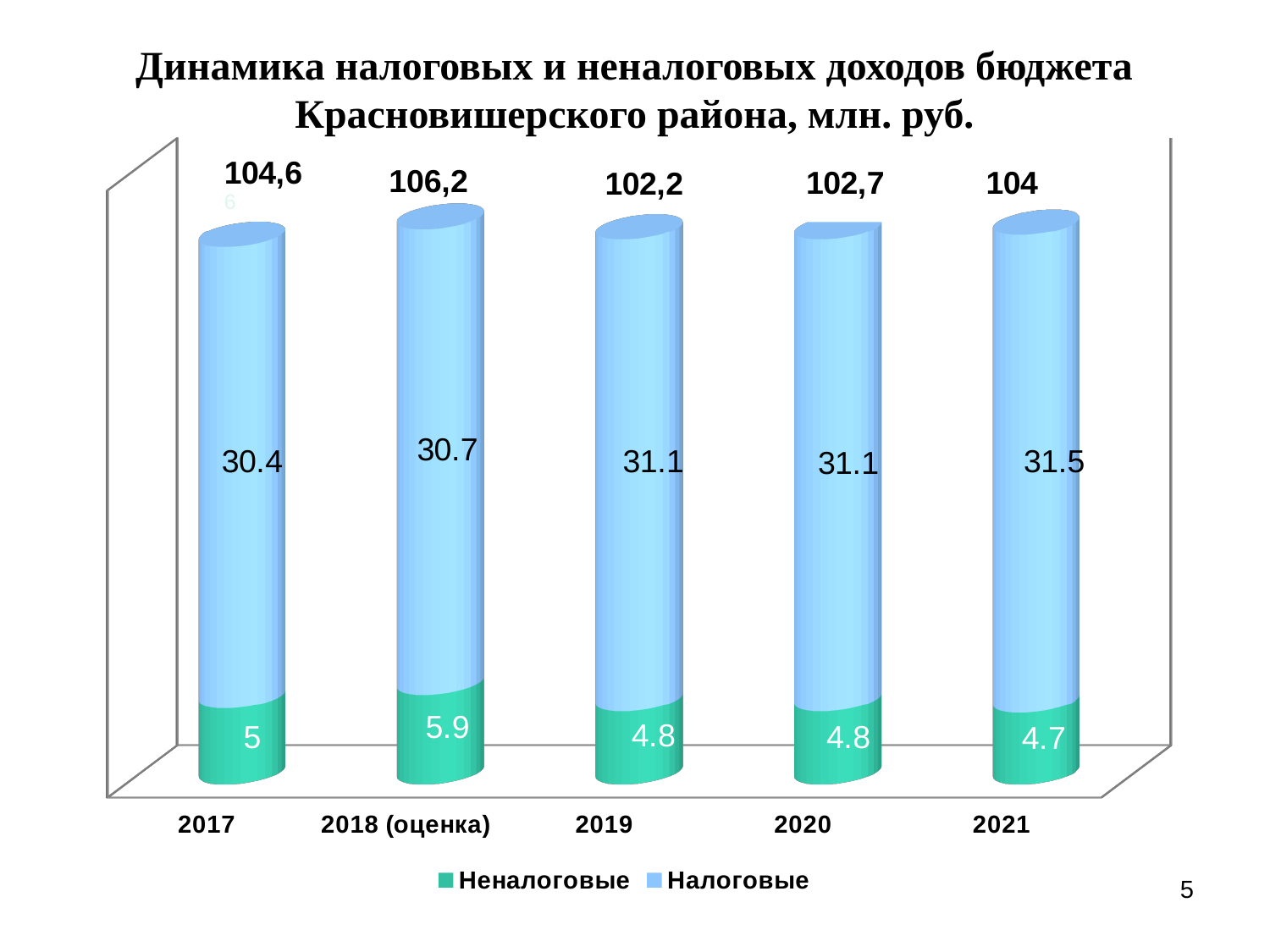
What is the value of Неналоговые for 2018 (оценка)? 5.9 How many series does the legend list? 2 What is the value of Налоговые for 2019? 31.1 Which year has the lowest Неналоговые value? 2021 What is the value of Налоговые for 2021? 31.5 Which year has the highest Неналоговые value? 2018 (оценка) What is the total of the stacked bar for 2018 (оценка)? 36.6 What is the difference between the Налоговые values for 2021 and 2017? 1.1 How many categories are shown on the x axis? 5 What kind of chart is shown on the slide? Stacked bar chart What is the value of Неналоговые for 2017? 5 Which year has the highest Налоговые value? 2021